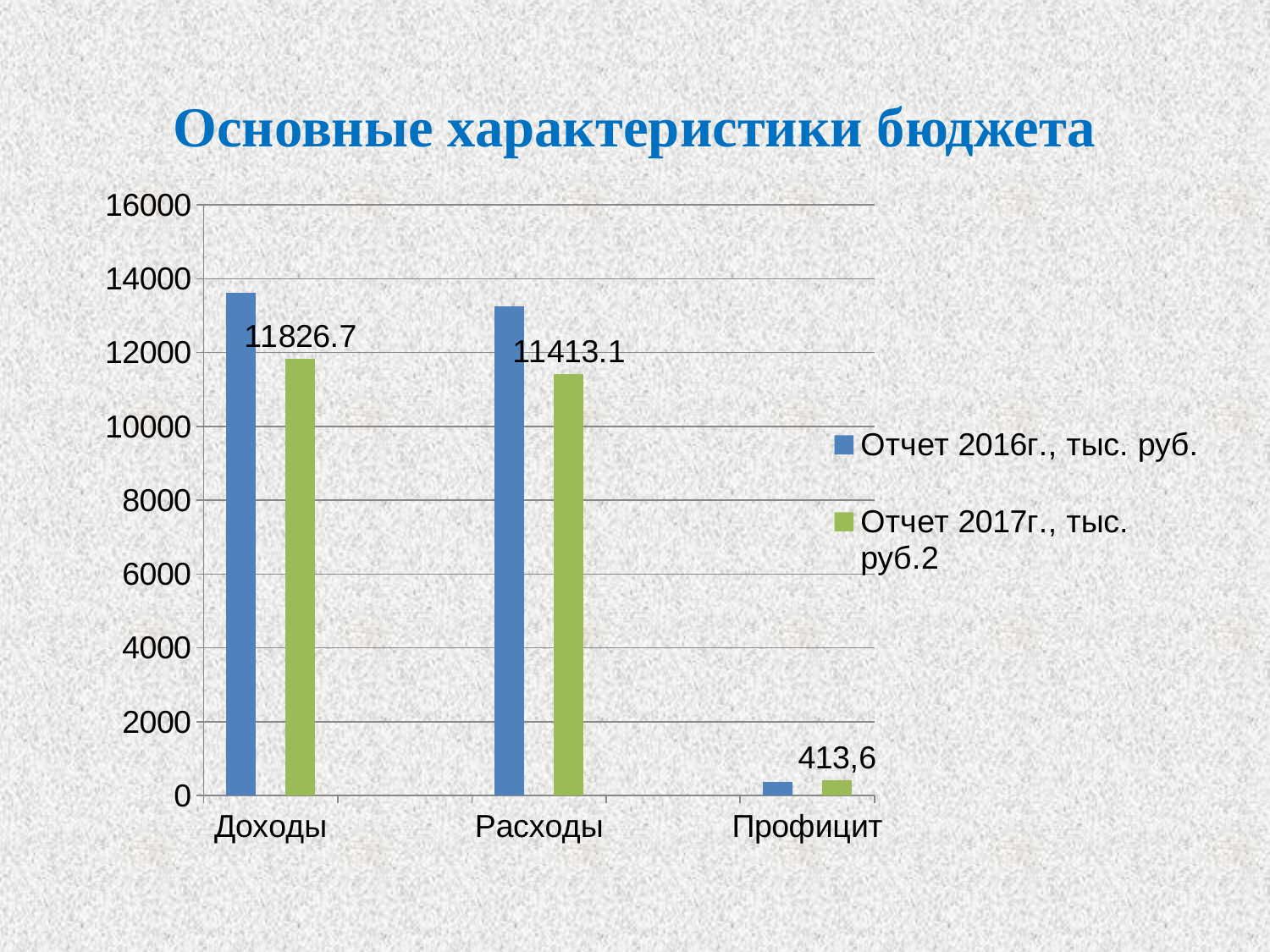
Is the value for Расходы in the series Отчет 2016г., тыс. руб. greater or less than 12000? greater What kind of chart is shown on the slide? bar chart What is the value for Расходы in the series Отчет 2017г., тыс. руб.2? 11413.1 What is the difference between Доходы and Расходы in the series Отчет 2017г., тыс. руб.2? 413.6 For Доходы, which series has the larger value: Отчет 2016г., тыс. руб. or Отчет 2017г., тыс. руб.2? Отчет 2016г., тыс. руб. Which category has the lowest value in the series Отчет 2017г., тыс. руб.2? Профицит Is the value for Профицит in the series Отчет 2016г., тыс. руб. greater or less than 2000? less How many series does the legend list? 2 How many categories are shown on the x axis? 3 What is the value for Доходы in the series Отчет 2017г., тыс. руб.2? 11826.7 What is the value for Профицит in the series Отчет 2017г., тыс. руб.2? 413,6 Which category has the highest value in the series Отчет 2017г., тыс. руб.2? Доходы